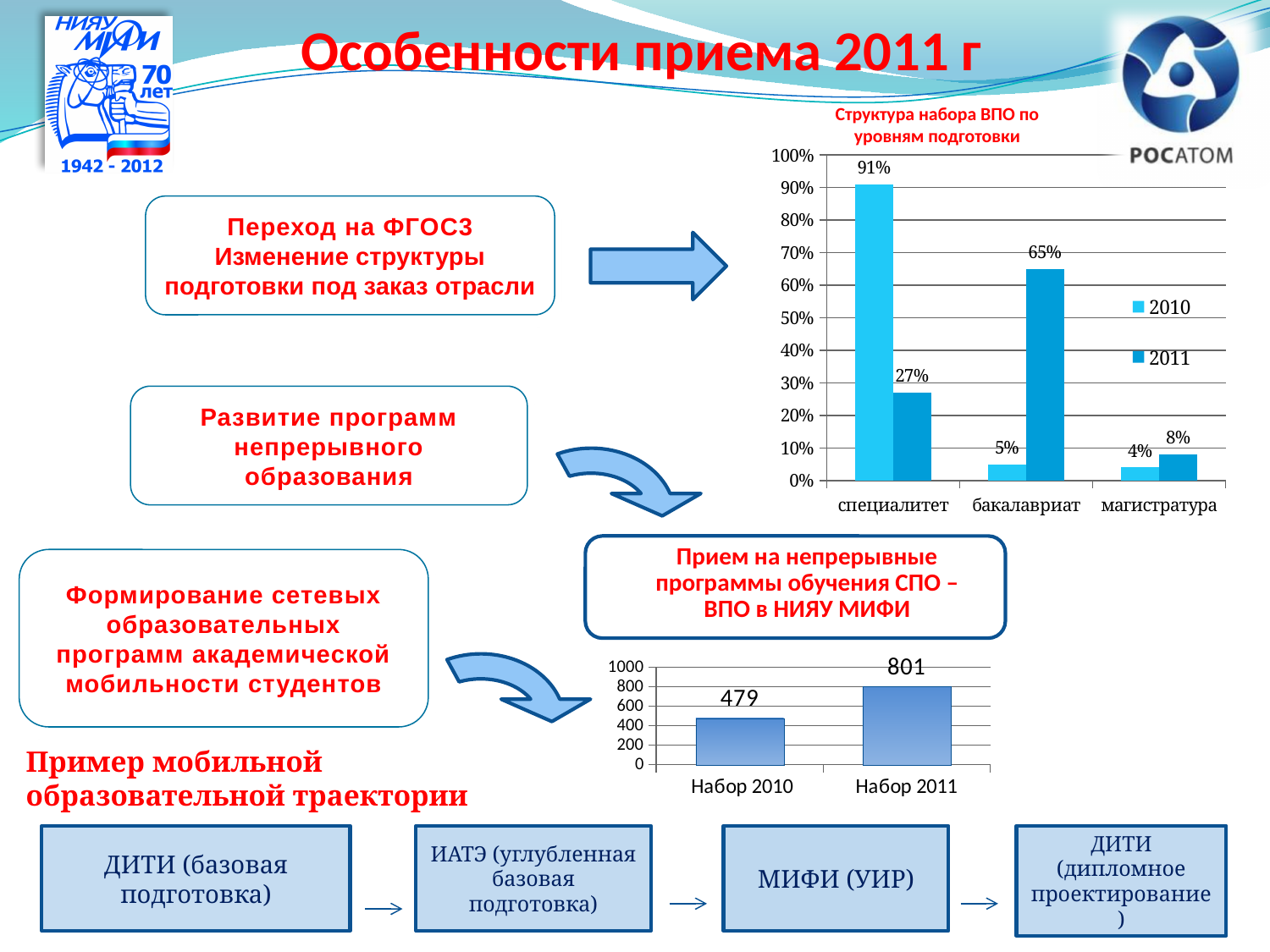
In the chart 'Структура набора ВПО по уровням подготовки', what is the value for бакалавриат in 2011? 65% In the chart 'Структура набора ВПО по уровням подготовки', what is the difference between the 2010 and 2011 values for специалитет? 64% How many categories are shown on the x axis of the chart 'Структура набора ВПО по уровням подготовки'? 3 In the bottom chart with Набор 2010 and Набор 2011, what is the value for Набор 2011? 801 In the chart 'Структура набора ВПО по уровням подготовки', which is larger for магистратура: the 2010 value or the 2011 value? 2011 In the chart 'Структура набора ВПО по уровням подготовки', what is the value for магистратура in 2010? 4% In the chart 'Структура набора ВПО по уровням подготовки', which category has the lowest value for 2010? магистратура What kind of chart is the bottom chart with Набор 2010 and Набор 2011? bar chart In the chart 'Структура набора ВПО по уровням подготовки', which category has the highest value for 2011? бакалавриат In the bottom chart with Набор 2010 and Набор 2011, what is the difference between the two values? 322 How many series does the legend of the chart 'Структура набора ВПО по уровням подготовки' list? 2 In the chart 'Структура набора ВПО по уровням подготовки', what is the value for специалитет in 2010? 91%